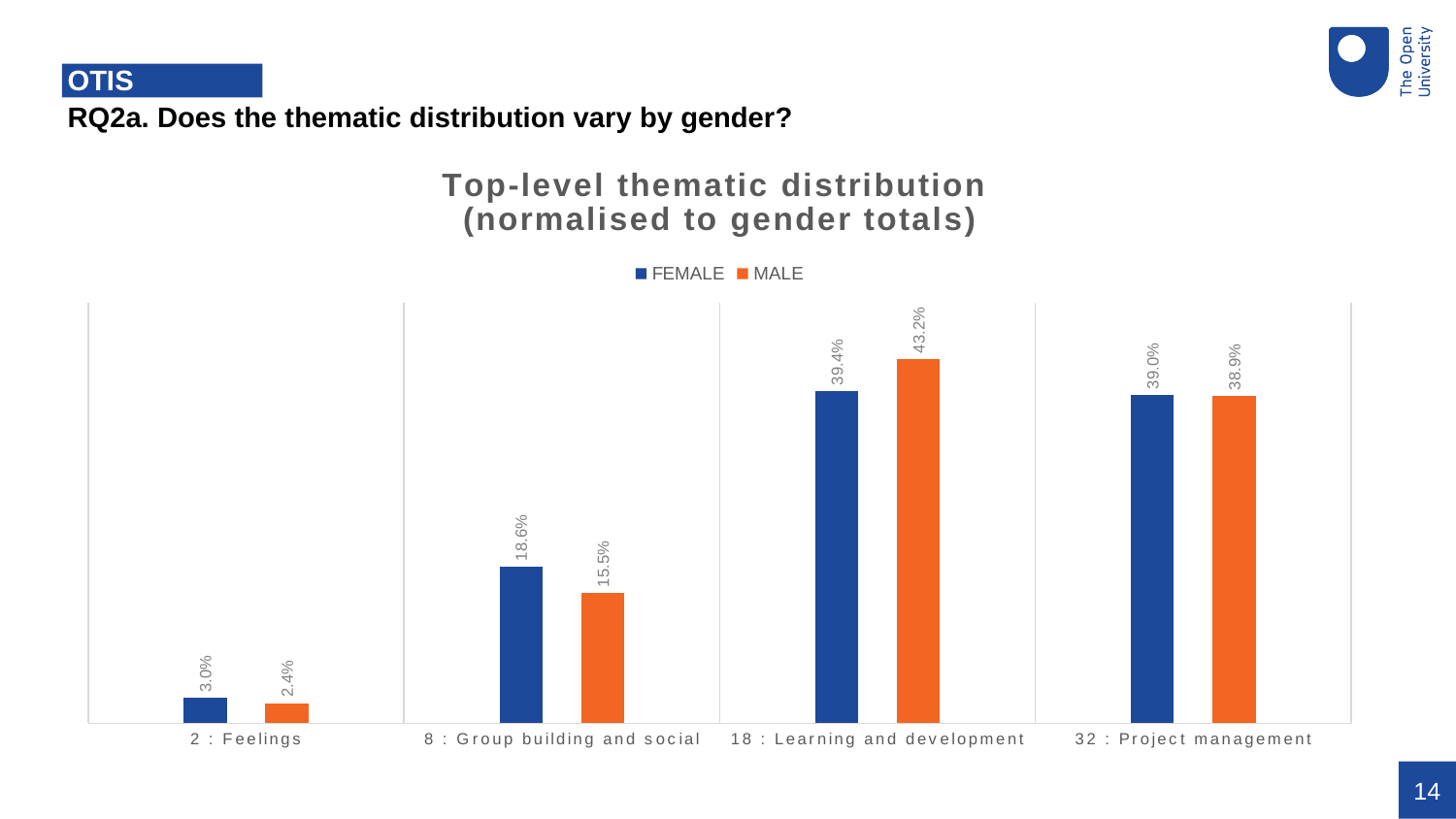
For 8 : Group building and social, which is larger, the FEMALE or the MALE value? FEMALE What kind of chart is shown on the slide? Bar chart What is the difference between the FEMALE and MALE values for 8 : Group building and social? 3.1 percentage points Which category has the lowest FEMALE value? 2 : Feelings What is the difference between the MALE and FEMALE values for 18 : Learning and development? 3.8 percentage points What is the FEMALE value for 18 : Learning and development? 39.4% How many categories are shown on the x axis? 4 What is the MALE value for 2 : Feelings? 2.4% Which category has the highest MALE value? 18 : Learning and development What is the MALE value for 8 : Group building and social? 15.5% What is the FEMALE value for 32 : Project management? 39.0% How many series does the legend list? 2